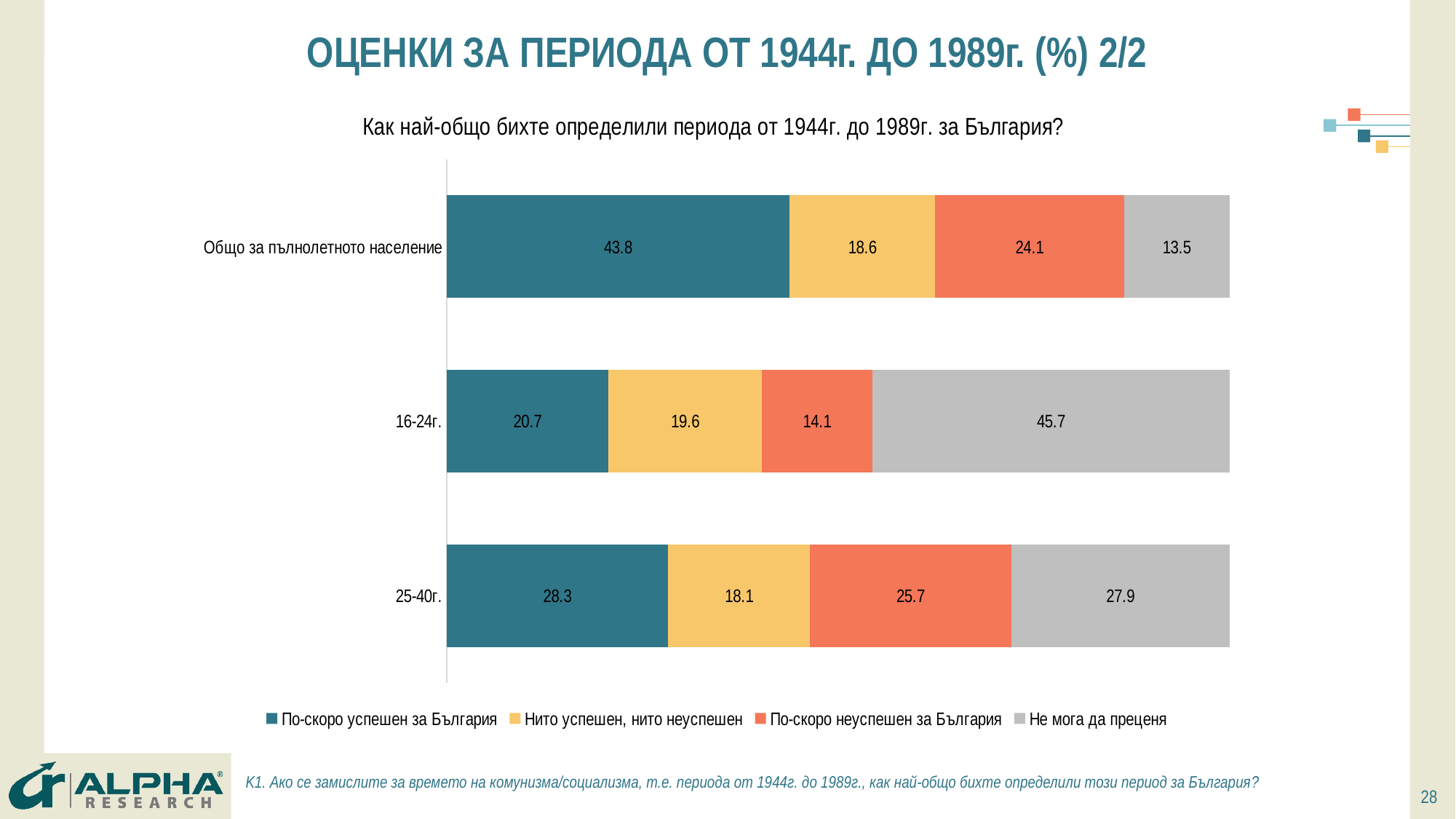
What kind of chart is shown on the slide? Stacked bar chart What is the value for "Не мога да преценя" in the "16-24г." bar? 45.7 In the "25-40г." bar, which is larger: "По-скоро успешен за България" or "По-скоро неуспешен за България"? По-скоро успешен за България What is the total of the "Общо за пълнолетното население" stacked bar? 100 Which category has the lowest value for "По-скоро успешен за България"? 16-24г. What is the value for "По-скоро успешен за България" in the "Общо за пълнолетното население" bar? 43.8 How many categories (bars) are shown in the chart? 3 What colour represents "Не мога да преценя" in the legend? Grey What is the difference between the "По-скоро успешен за България" values for "Общо за пълнолетното население" and "16-24г."? 23.1 What is the value for "По-скоро неуспешен за България" in the "25-40г." bar? 25.7 Which category has the highest value for "Не мога да преценя"? 16-24г. How many series does the legend list? 4